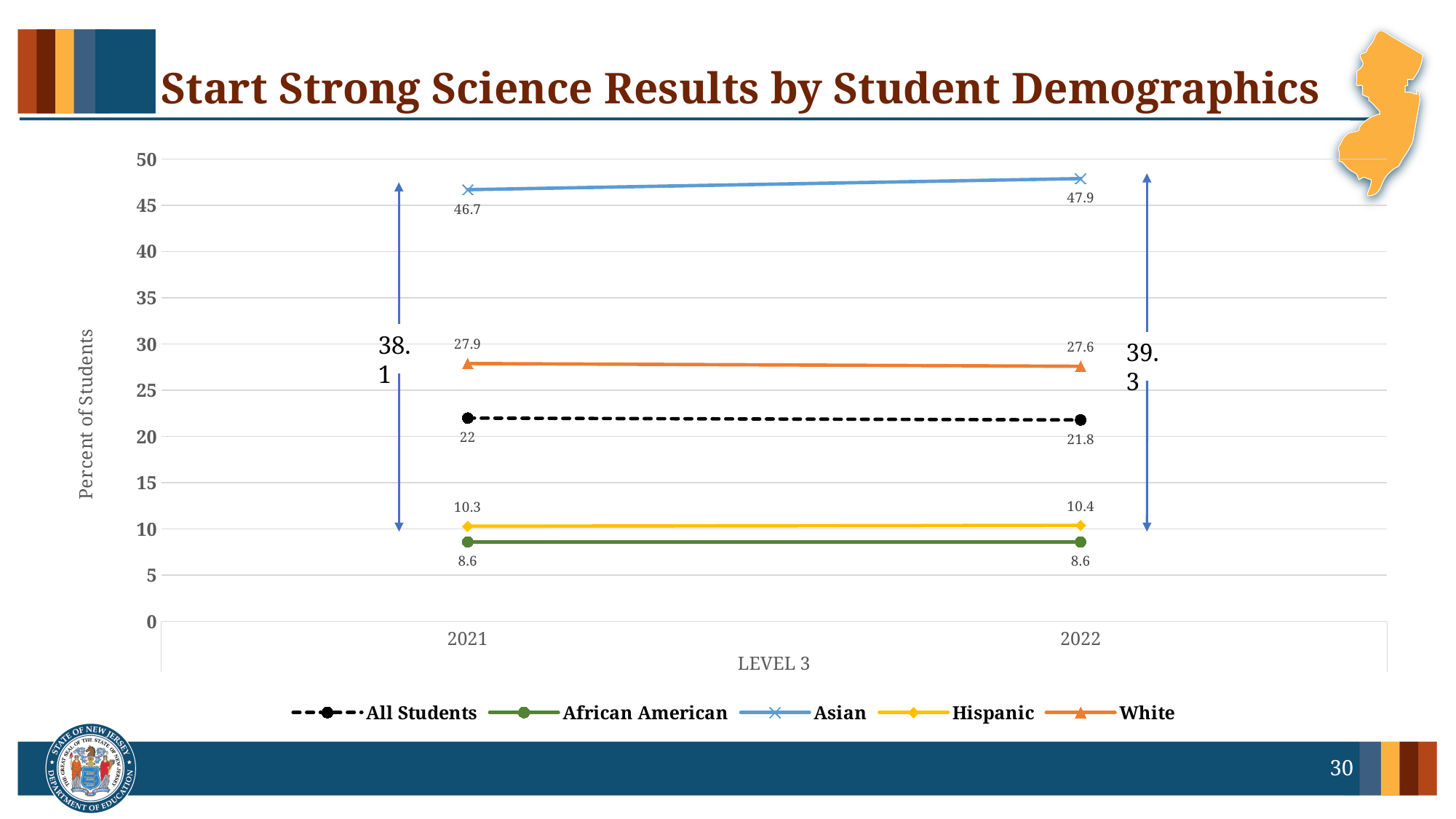
Which series has the lowest value in 2021? African American What is the value for Asian students in 2022? 47.9 How many series does the legend list? 5 What kind of chart is shown on the slide? Line chart Which series has the highest value in 2022? Asian Does the value for Asian students rise or fall from 2021 to 2022? Rise What is the value for Hispanic students in 2021? 10.3 Which is larger in 2022, the value for White students or the value for All Students? White What is the value for All Students in 2022? 21.8 What is the difference between the Asian and African American values in 2021? 38.1 What is the value for White students in 2021? 27.9 Is the value for Asian students in 2021 greater or less than 45? greater